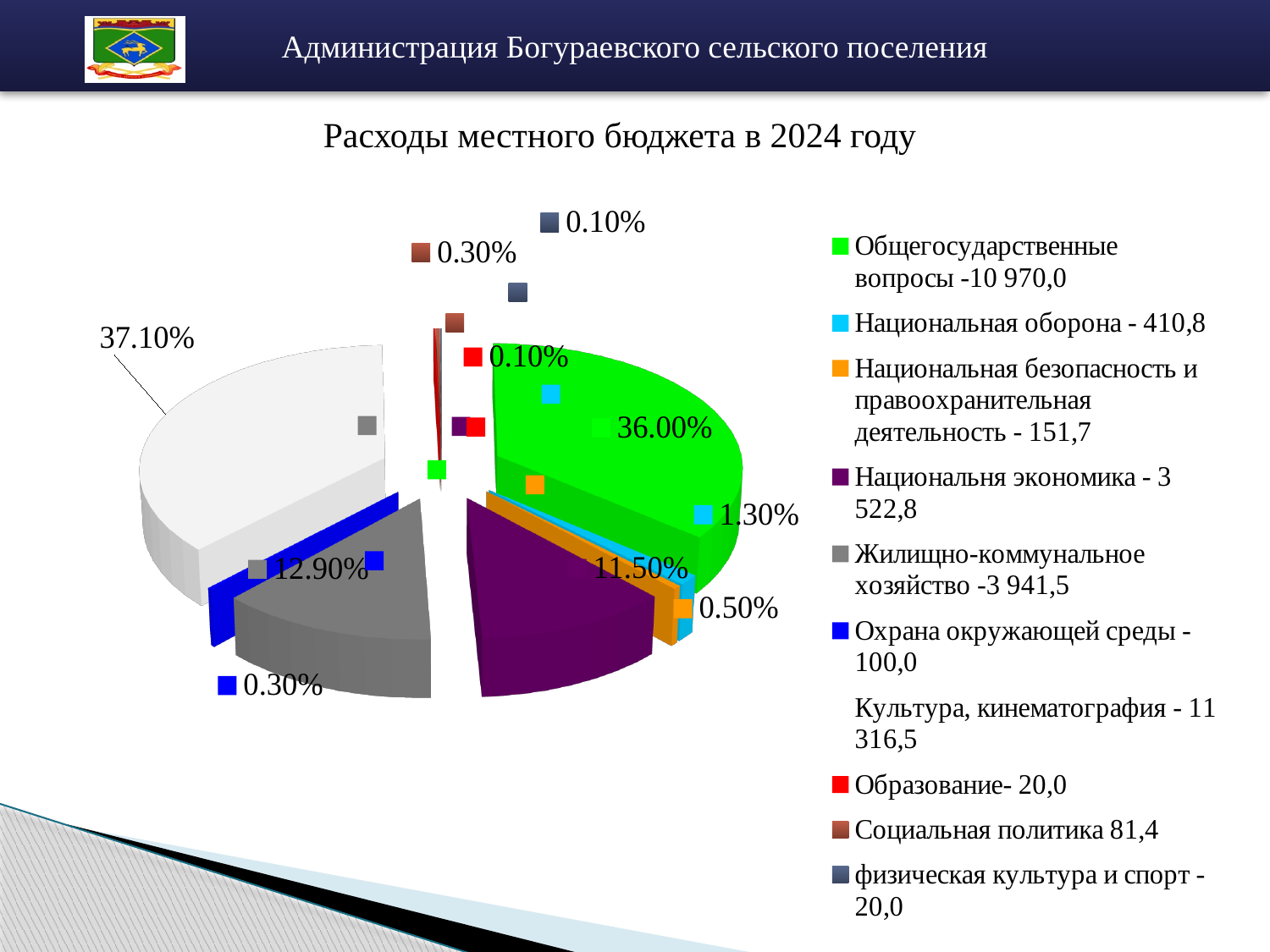
What kind of chart is shown on the slide? pie chart How many categories does the legend list? 10 What value is given in the legend for Социальная политика? 81,4 What share of the pie does Общегосударственные вопросы have? 36.00% Which is larger, the share for Жилищно-коммунальное хозяйство or the share for Национальная экономика? Жилищно-коммунальное хозяйство What value is given in the legend for Национальная экономика? 3 522,8 Which category has the largest share of the pie? Культура, кинематография What is the title of the chart? Расходы местного бюджета в 2024 году What share of the pie does Национальная экономика have? 11.50% What share of the pie does Жилищно-коммунальное хозяйство have? 12.90% What is the difference in percentage points between the share for Культура, кинематография and the share for Общегосударственные вопросы? 1.10%